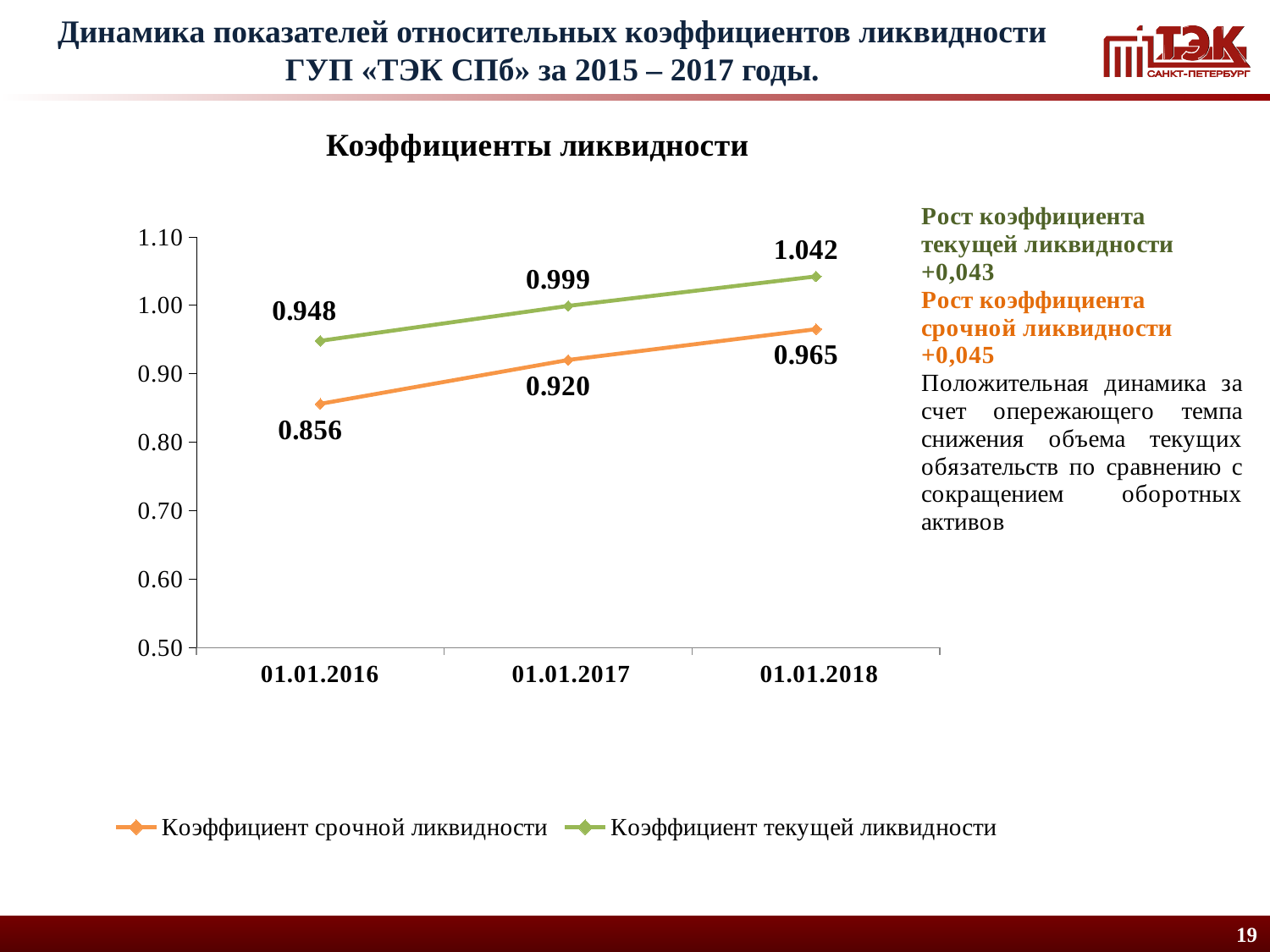
What is the value of Коэффициент срочной ликвидности on 01.01.2017? 0.920 How many series does the legend list? 2 On which date is Коэффициент текущей ликвидности lowest? 01.01.2016 On which date is Коэффициент срочной ликвидности highest? 01.01.2018 What is the value of Коэффициент срочной ликвидности on 01.01.2016? 0.856 Do the values of Коэффициент срочной ликвидности rise or fall from 01.01.2016 to 01.01.2018? rise What is the value of Коэффициент текущей ликвидности on 01.01.2018? 1.042 How many dates are plotted on the x axis? 3 What is the difference between Коэффициент текущей ликвидности and Коэффициент срочной ликвидности on 01.01.2018? 0.077 What type of chart is shown on the slide? line chart What is the value of Коэффициент текущей ликвидности on 01.01.2016? 0.948 Which is larger on 01.01.2017: Коэффициент текущей ликвидности or Коэффициент срочной ликвидности? Коэффициент текущей ликвидности